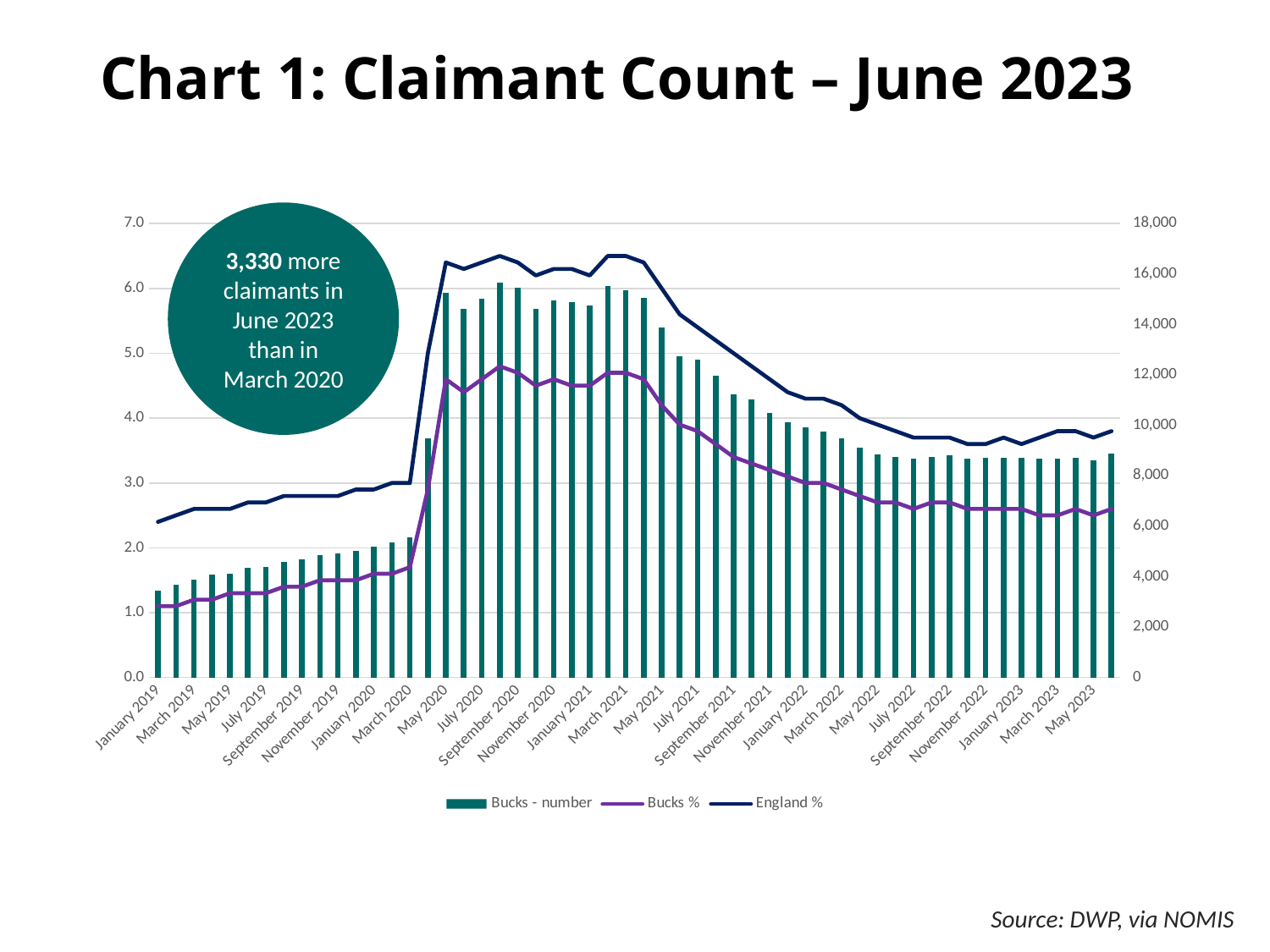
In May 2020, which is higher: Bucks % or England %? England % According to the callout on the chart, how many more claimants were there in June 2023 than in March 2020? 3,330 Does the Bucks % line rise or fall between May 2021 and July 2022? Fall Is the England % value for May 2020 greater or less than 6.0? greater Is the Bucks - number value for May 2020 greater or less than 14,000? greater Is the Bucks % value for January 2019 greater or less than 2.0? less What kind of chart is this? A combined bar and line chart How many series does the legend list? 3 What is the title of the chart? Chart 1: Claimant Count – June 2023 Which is larger: the Bucks - number value for May 2020 or for January 2019? May 2020